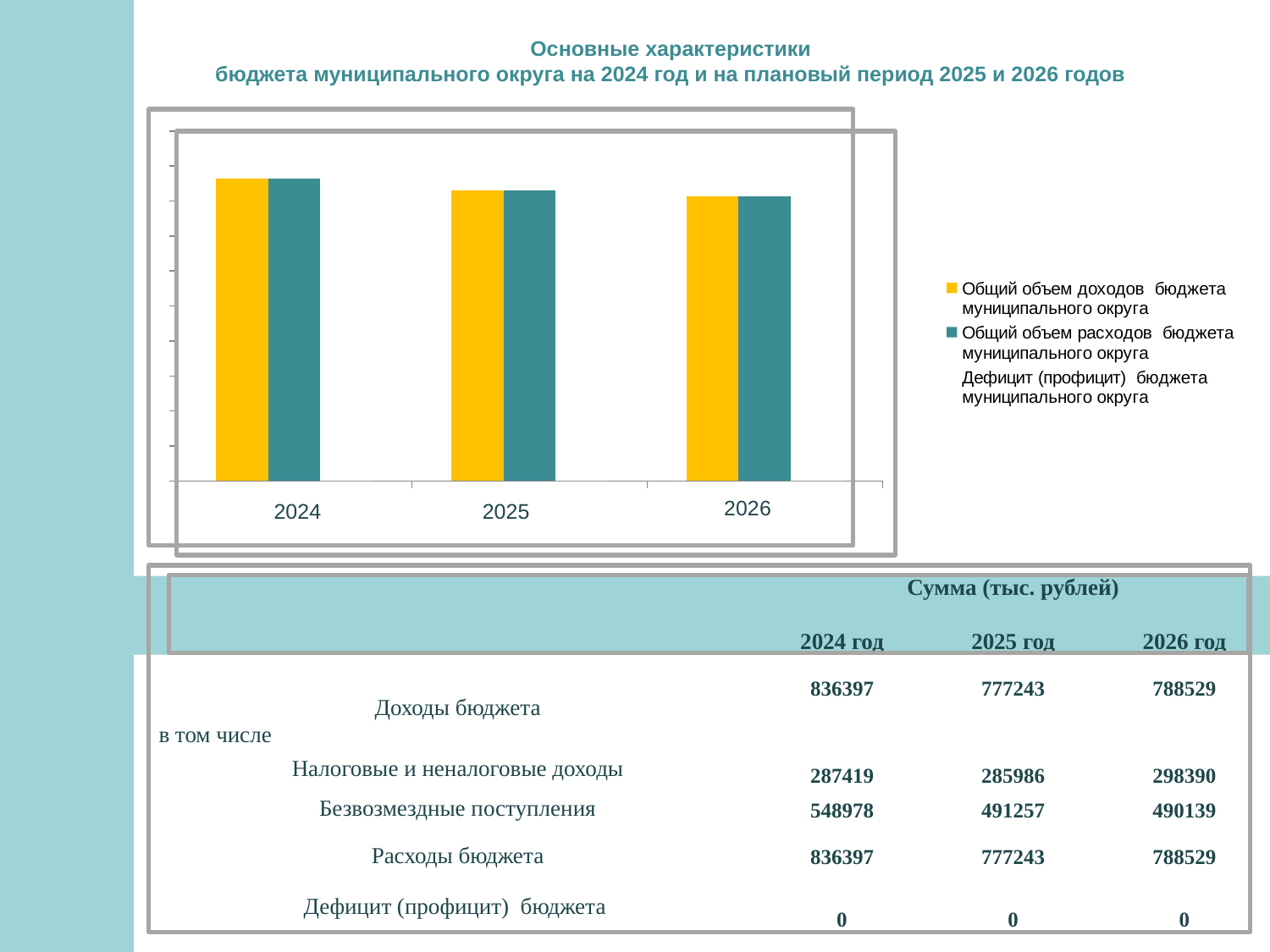
Which year has the highest bar for "Общий объем расходов бюджета муниципального округа"? 2024 Which is larger: the "Общий объем расходов" bar for 2024 or for 2026? 2024 What colour are the bars for "Общий объем доходов бюджета муниципального округа"? yellow What is the first category label on the x axis of the chart? 2024 Which year has the highest bar for "Общий объем доходов бюджета муниципального округа"? 2024 How many years (categories) are shown on the x axis of the chart? 3 Does the "Общий объем доходов" bar rise or fall from 2024 to 2025? fall Does the "Общий объем расходов" bar rise or fall from 2024 to 2026? fall Which is larger: the "Общий объем доходов" bar for 2024 or for 2025? 2024 What kind of chart is shown on the slide? bar chart How many series does the chart legend list? 3